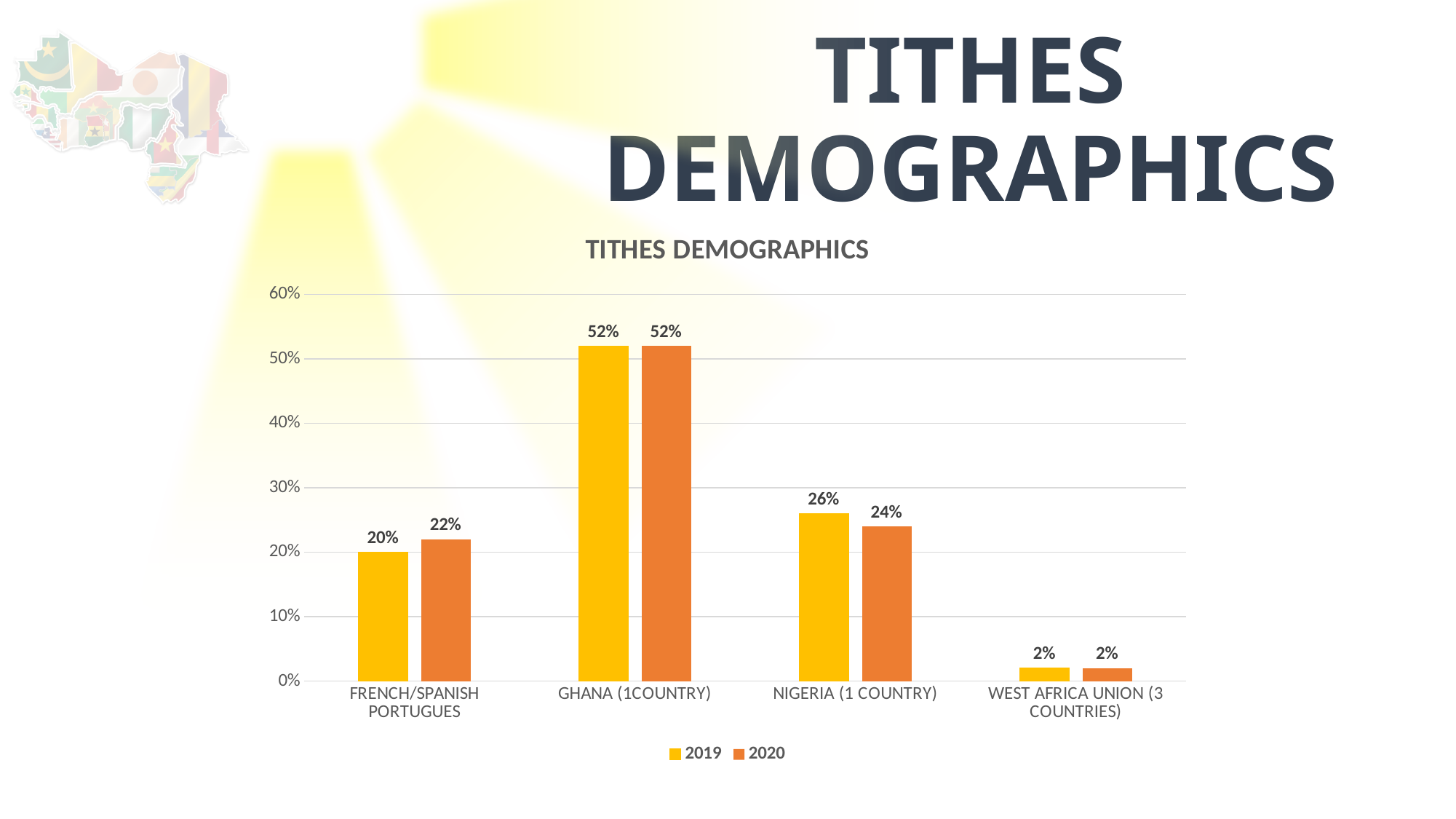
How many categories are shown on the x axis? 4 What is the 2020 value for Nigeria (1 country)? 24% What is the 2020 value for French/Spanish Portugues? 22% Which is larger for French/Spanish Portugues, the 2019 value or the 2020 value? 2020 Which category has the highest 2019 value? Ghana (1country) What kind of chart is shown on the slide? Bar chart How many series does the legend list? 2 What is the 2019 value for West Africa Union (3 countries)? 2% Which category has the lowest 2020 value? West Africa Union (3 countries) What is the difference between the 2019 and 2020 values for Nigeria (1 country)? 2% What is the title of the chart? TITHES DEMOGRAPHICS What is the 2019 value for Ghana (1country)? 52%